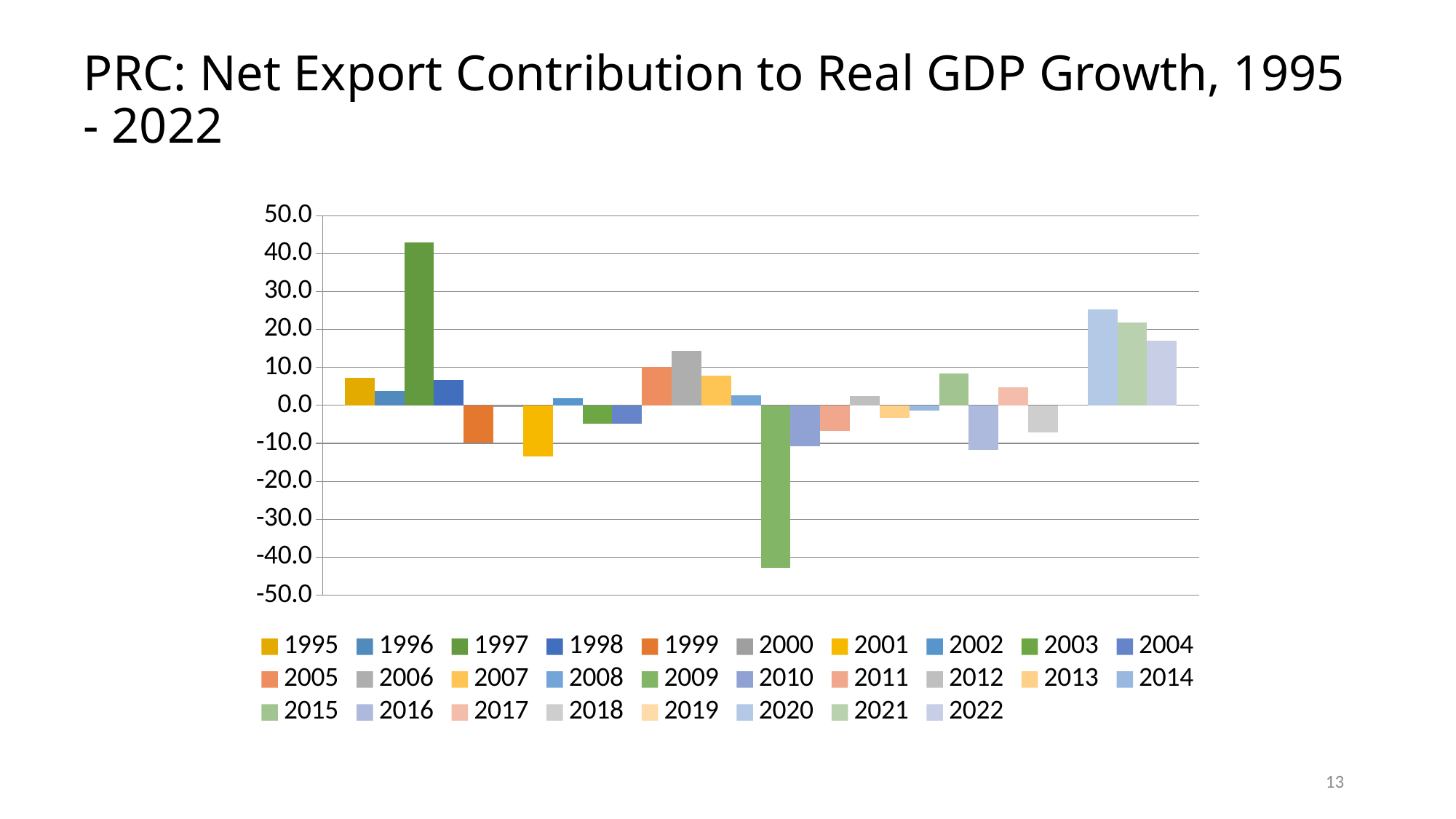
Which year has the highest net export contribution to real GDP growth? 1997 Is the value for 2020 greater or less than 20.0? greater Which year has the lowest net export contribution to real GDP growth? 2009 Is the value for 2009 greater or less than -40.0? less Is the value for 1997 greater or less than 40.0? greater Do the values rise or fall from 2020 to 2022? fall What is the title of the chart on the slide? PRC: Net Export Contribution to Real GDP Growth, 1995 - 2022 Which is larger, the value for 2020 or the value for 2022? 2020 What kind of chart is shown on the slide? bar chart How many series does the legend list? 28